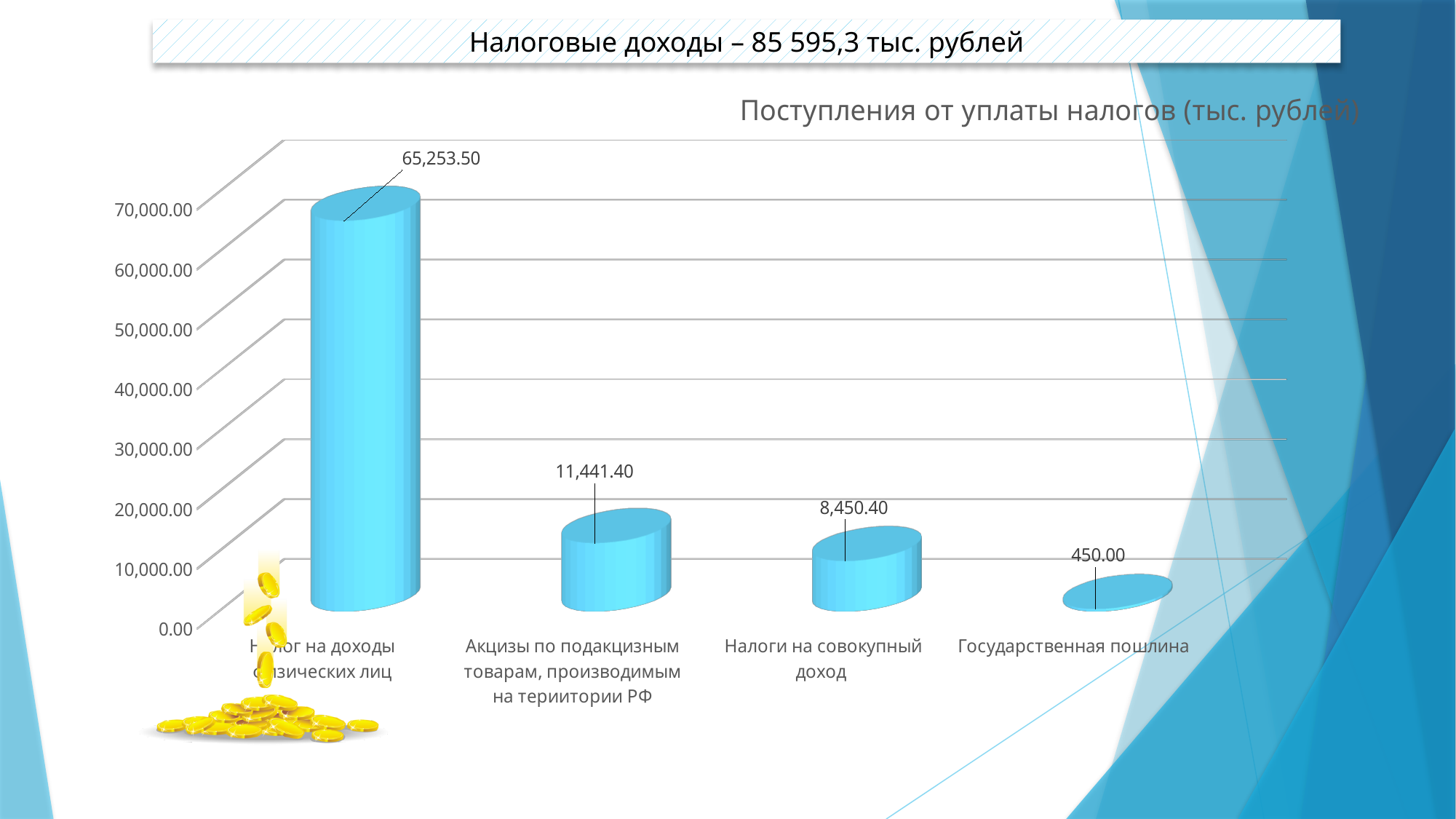
What is the difference between the values for Налоги на совокупный доход and Государственная пошлина? 8,000.40 What is the value for Налоги на совокупный доход? 8,450.40 Which is larger, the value for Акцизы по подакцизным товарам, производимым на территории РФ or the value for Налоги на совокупный доход? Акцизы по подакцизным товарам, производимым на территории РФ What is the difference between the values for Акцизы по подакцизным товарам, производимым на территории РФ and Налоги на совокупный доход? 2,991.00 Which category has the lowest value? Государственная пошлина Which category has the highest value? Налог на доходы физических лиц What kind of chart is shown on the slide? Bar chart How many categories are shown in the chart? 4 What is the title of the chart? Поступления от уплаты налогов (тыс. рублей) What is the value for Государственная пошлина? 450.00 What is the value for Акцизы по подакцизным товарам, производимым на территории РФ? 11,441.40 What is the value for Налог на доходы физических лиц? 65,253.50